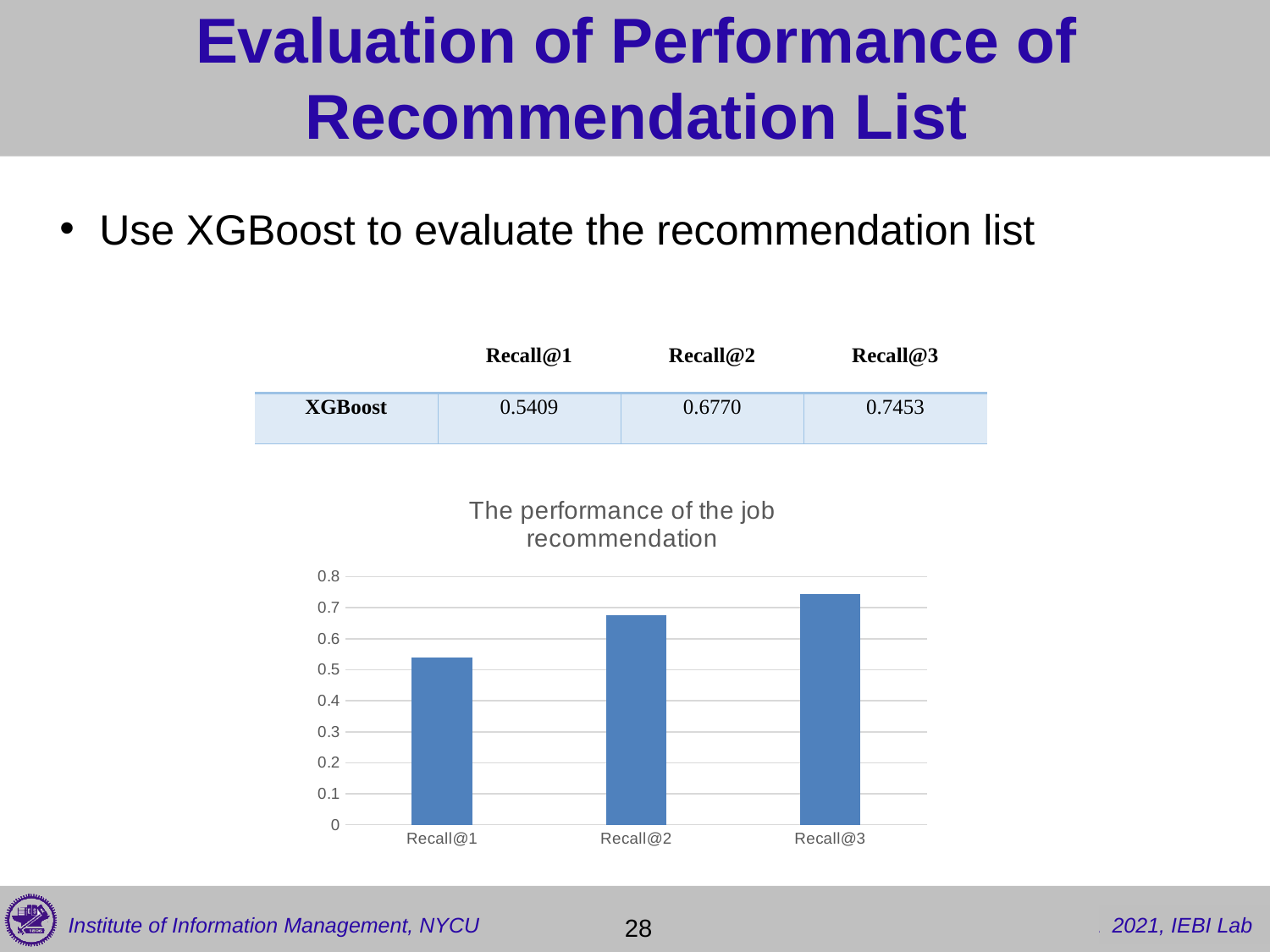
What is the title of the chart? The performance of the job recommendation Is the value for Recall@3 greater or less than 0.7? greater According to the table on the slide, what is the XGBoost value for Recall@2? 0.6770 Using the values in the table, what is the difference between Recall@3 and Recall@1 for XGBoost? 0.2044 Which category has the highest bar in the chart? Recall@3 Do the bar values rise or fall from Recall@1 to Recall@3? rise Which is larger, the bar for Recall@2 or the bar for Recall@1? Recall@2 How many categories are plotted in the chart? 3 Is the value for Recall@1 greater or less than 0.5? greater What type of chart is shown on the slide? bar chart Is the value for Recall@2 greater or less than 0.7? less Which category has the lowest bar in the chart? Recall@1